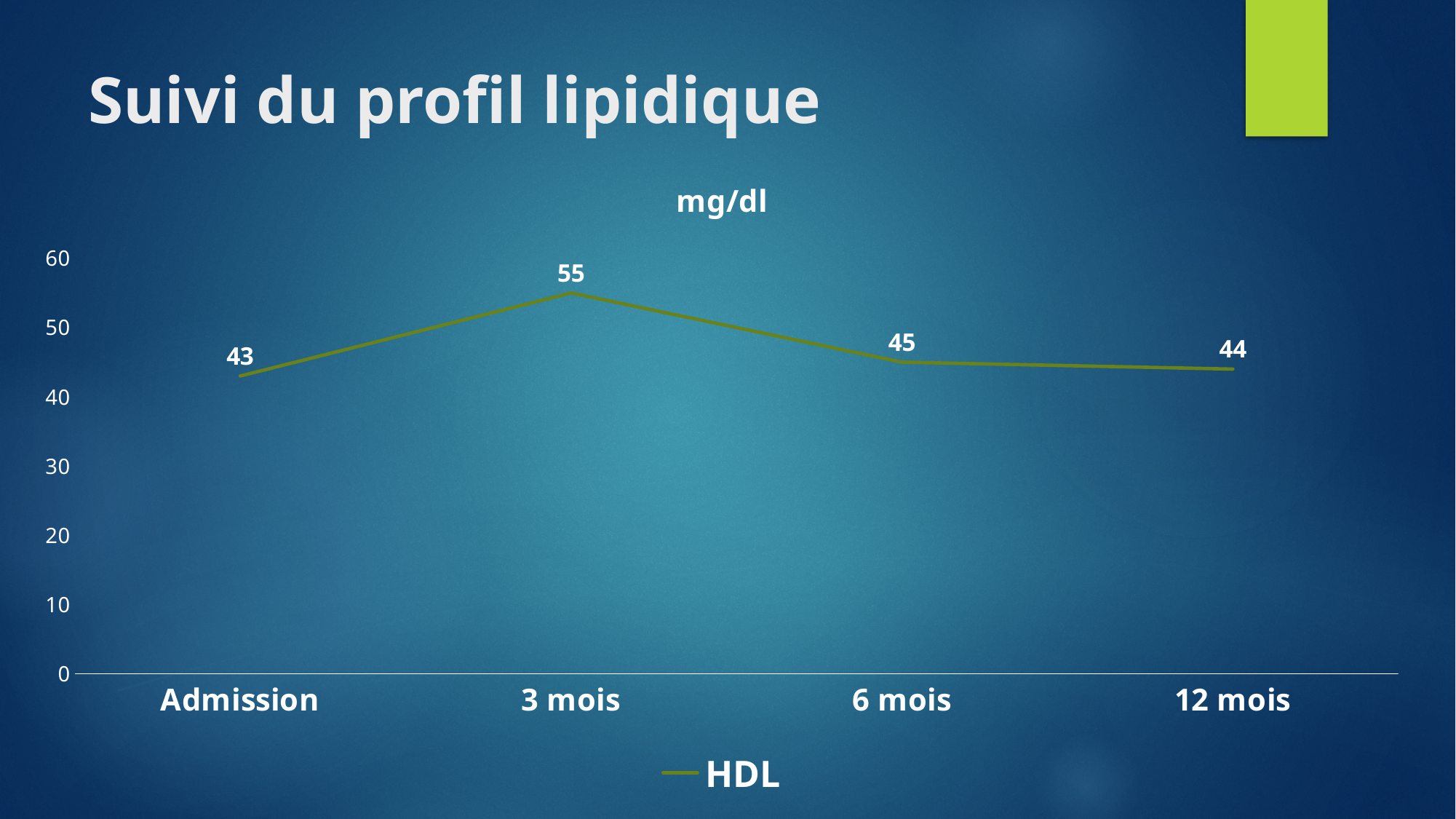
What is the title of the chart? mg/dl What is the difference between the HDL value at 3 mois and at Admission? 12 How many time points are plotted on the chart? 4 What kind of chart is shown on the slide? line chart What is the HDL value at 3 mois? 55 Is the HDL value at 3 mois greater or less than 50? greater What is the HDL value at 6 mois? 45 At which time point is the HDL value lowest? Admission What is the HDL value at 12 mois? 44 Which is larger, the HDL value at 6 mois or at 12 mois? 6 mois What is the HDL value at Admission? 43 At which time point is the HDL value highest? 3 mois